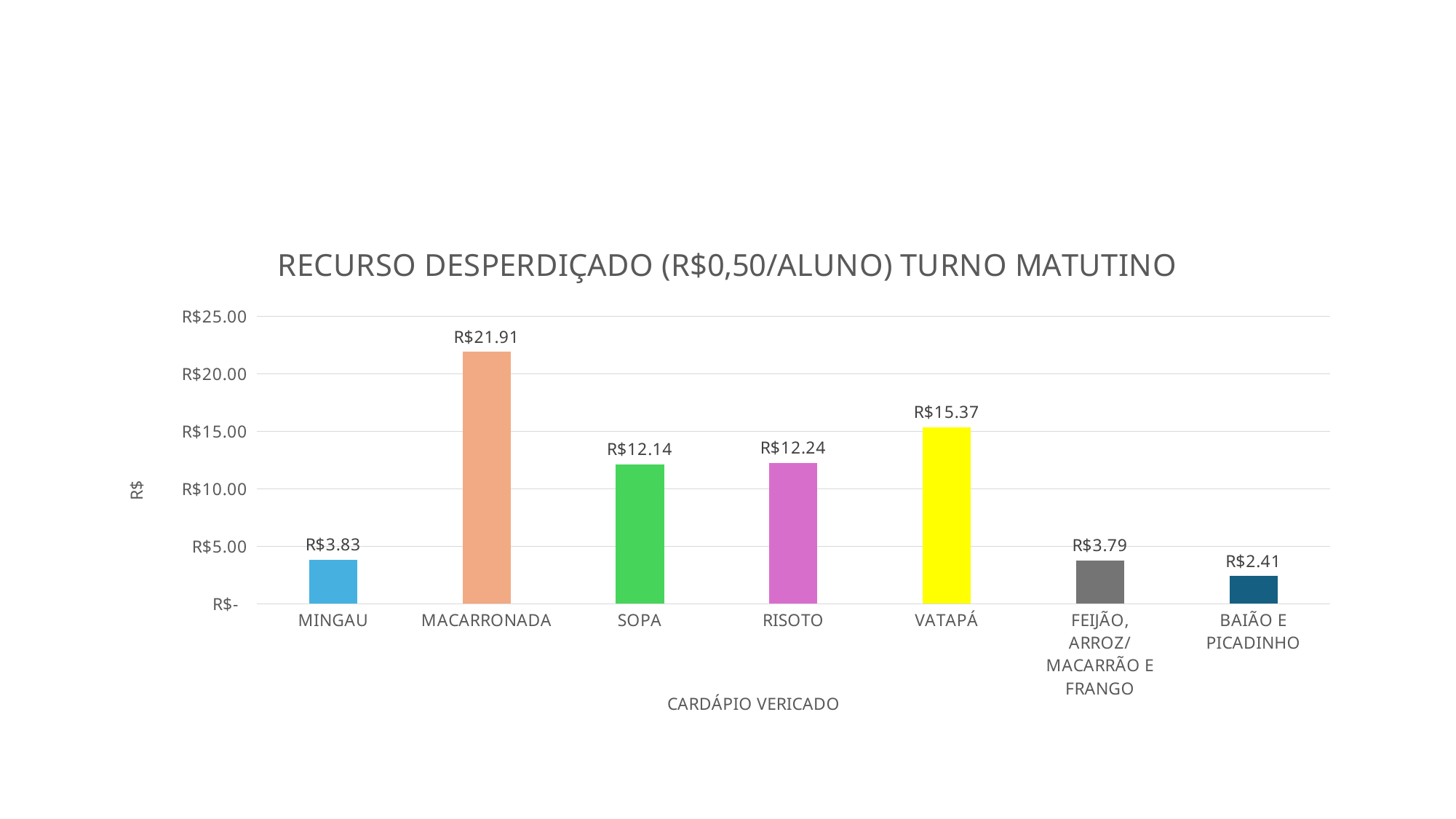
Which category has the highest value? MACARRONADA What is the difference between the values for MACARRONADA and VATAPÁ? R$6.54 What is the value for BAIÃO E PICADINHO? R$2.41 What is the value for MACARRONADA? R$21.91 Is the value for RISOTO greater or less than R$10.00? greater What kind of chart is shown on the slide? bar chart Which is larger, the value for SOPA or the value for VATAPÁ? VATAPÁ What is the value for VATAPÁ? R$15.37 Which category has the lowest value? BAIÃO E PICADINHO What is the title of the chart? RECURSO DESPERDIÇADO (R$0,50/ALUNO) TURNO MATUTINO How many categories are shown on the x axis? 7 What is the label of the x axis? CARDÁPIO VERICADO